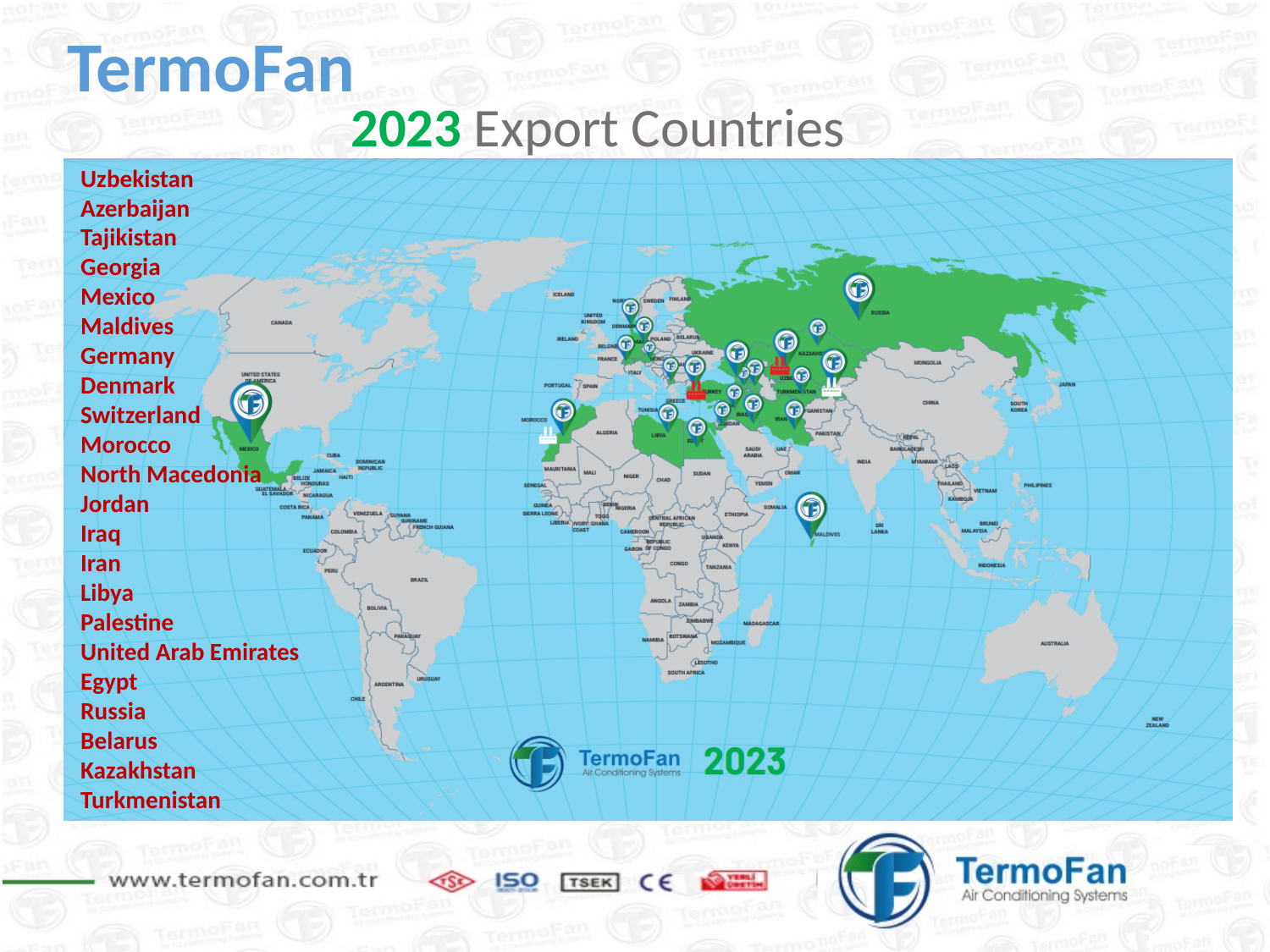
Which country is listed last in the export countries list? Turkmenistan Which country is listed first in the export countries list? Uzbekistan What kind of chart is shown on the slide? A map What is the title of the chart on the slide? 2023 Export Countries How many export countries are listed on the slide? 22 Which year does the export countries map refer to? 2023